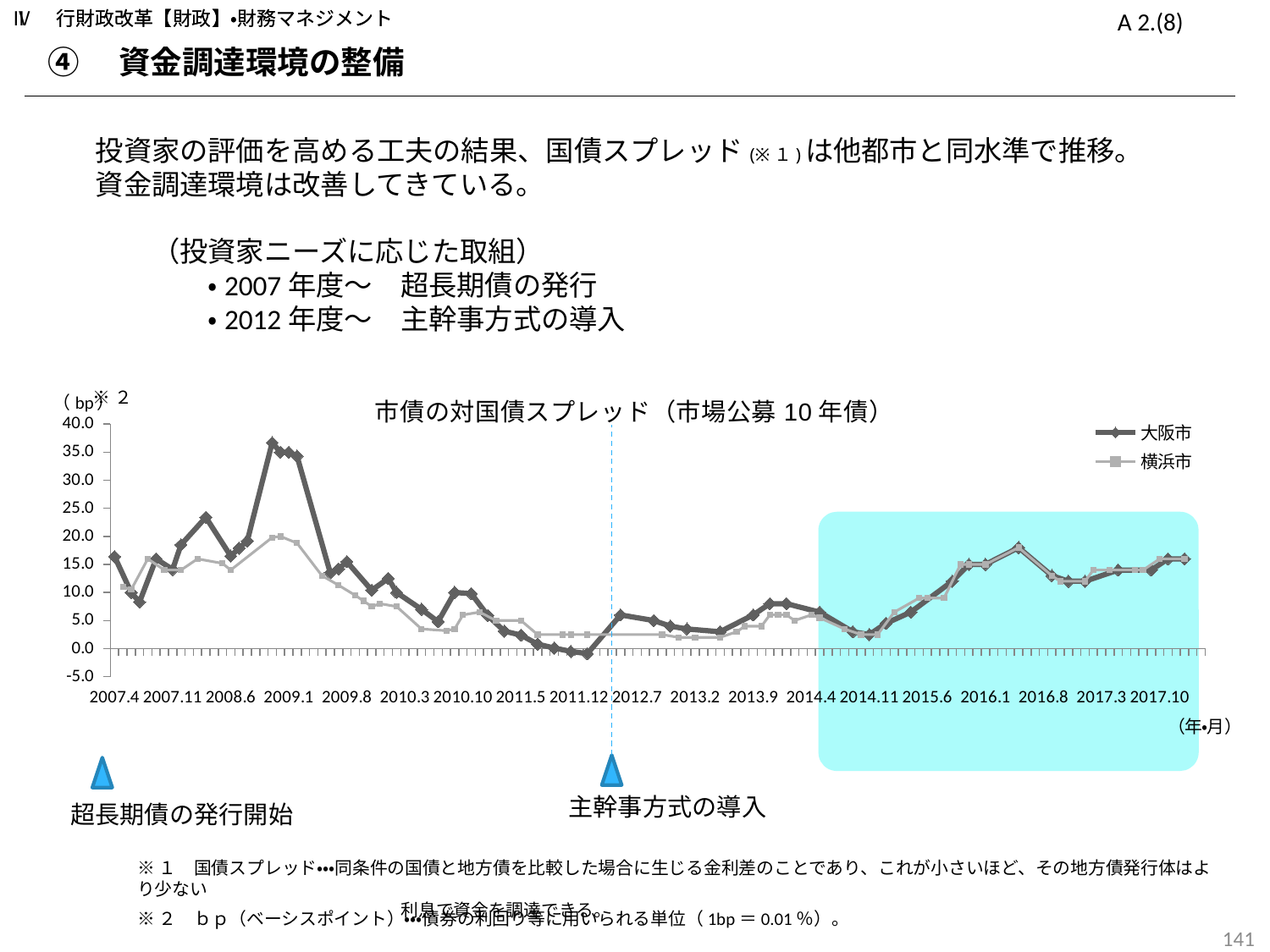
Is the value for 大阪市 at 2009.1 greater or less than 25.0? greater Is the value for 横浜市 at 2009.1 greater or less than 25.0? less Is the value for 大阪市 at 2011.12 greater or less than 5.0? less What kind of chart is shown on the slide? line chart How many labels are shown along the x axis of the chart? 19 What is the title of the chart? 市債の対国債スプレッド（市場公募10年債） How many series does the legend of the chart list? 2 At 2009.1, which series has the larger value, 大阪市 or 横浜市? 大阪市 Does the 大阪市 line rise or fall between 2009.1 and 2011.12? fall Which series reaches the highest value anywhere on the chart? 大阪市 What unit is shown on the vertical axis of the chart? bp